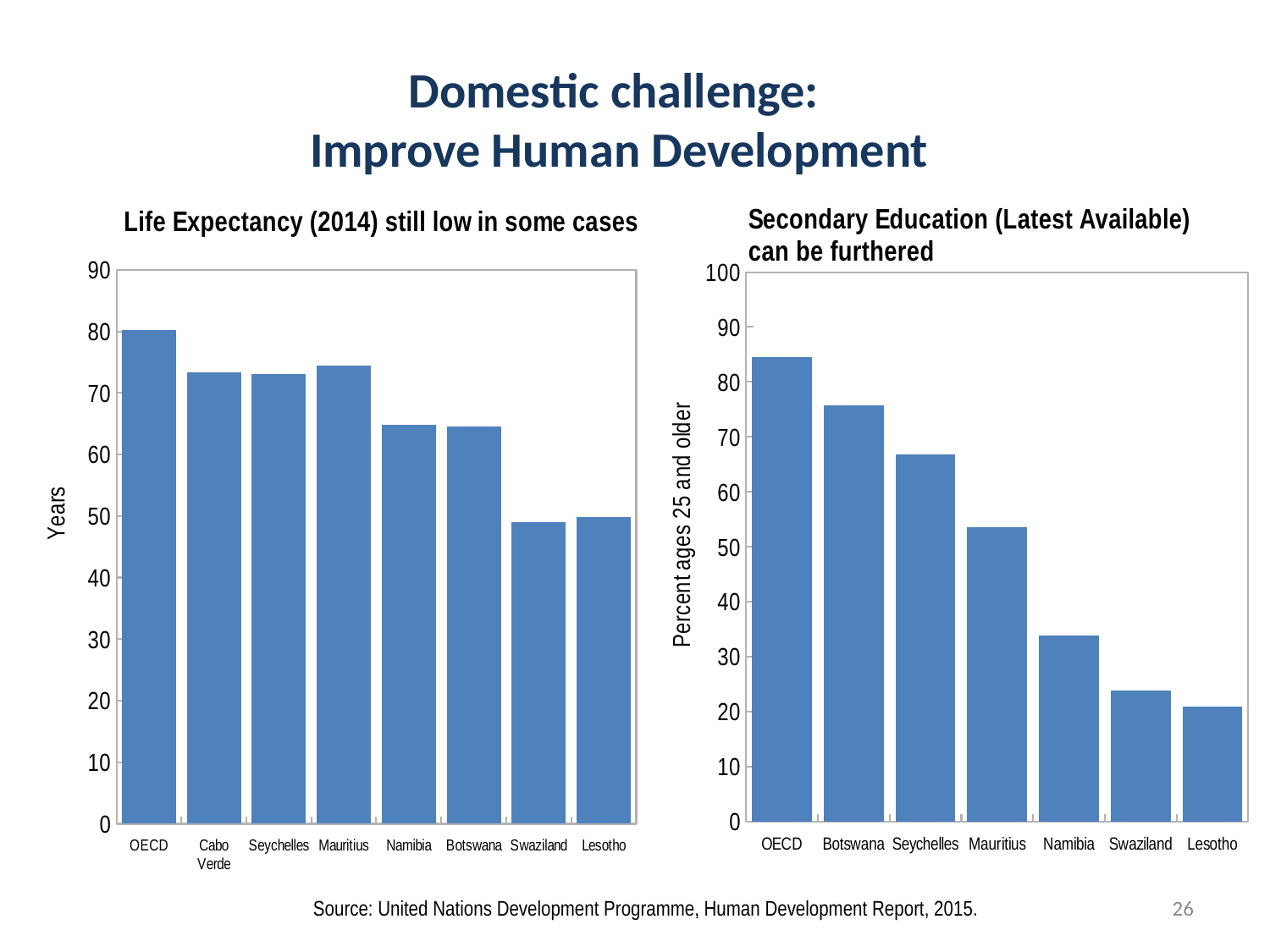
In the Secondary Education (Latest Available) chart, is the value for Botswana greater or less than 70? greater In the Secondary Education (Latest Available) chart, is the value for Namibia greater or less than 40? less In the Secondary Education (Latest Available) chart, do the values rise or fall from left to right along the x axis? fall In the Life Expectancy (2014) chart, which is larger, the value for Namibia or the value for Swaziland? Namibia In the Secondary Education (Latest Available) chart, how many categories are shown on the x axis? 7 In the Secondary Education (Latest Available) chart, which category has the lowest value? Lesotho What kind of chart is the Life Expectancy (2014) chart on the left? bar chart What is the y-axis label of the Secondary Education (Latest Available) chart? Percent ages 25 and older In the Secondary Education (Latest Available) chart, which category has the highest value? OECD In the Life Expectancy (2014) chart, which category has the highest value? OECD In the Life Expectancy (2014) chart, how many categories are shown on the x axis? 8 In the Life Expectancy (2014) chart, is the value for Namibia greater or less than 70? less